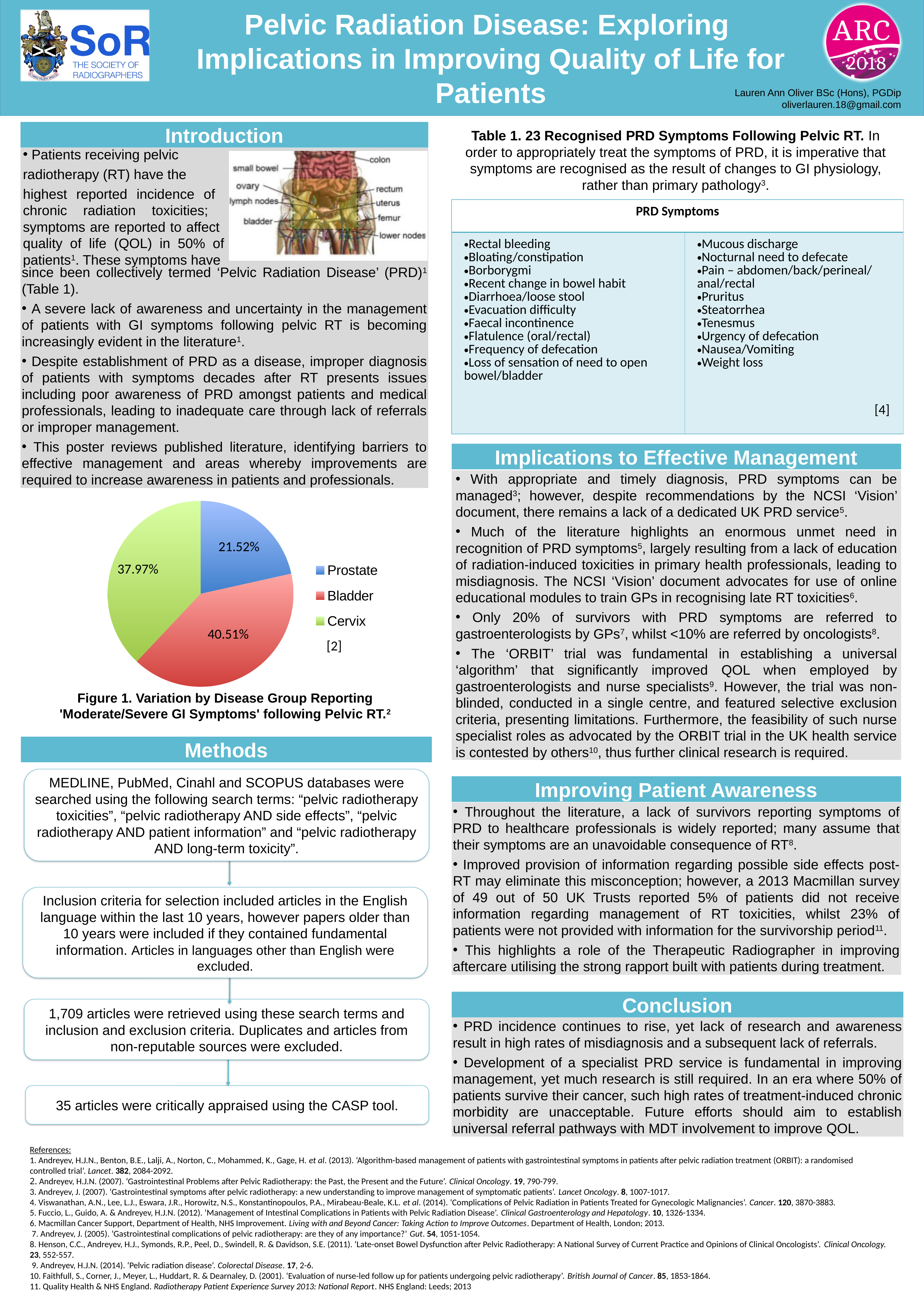
In Figure 1, what percentage is shown for Cervix? 37.97% In Figure 1, which is larger, the share for Cervix or the share for Prostate? Cervix In Figure 1, which colour represents Cervix in the pie chart? green In Figure 1, which disease group has the largest share? Bladder How many disease groups are shown in the pie chart in Figure 1? 3 In Figure 1, which disease group has the smallest share? Prostate How many entries does the legend of Figure 1 list? 3 In Figure 1, what is the difference in percentage points between Cervix and Prostate? 16.45 In Figure 1, what is the difference in percentage points between Bladder and Prostate? 18.99 In Figure 1, what percentage is shown for Prostate? 21.52% What type of chart is Figure 1? pie chart In Figure 1, what percentage is shown for Bladder? 40.51%